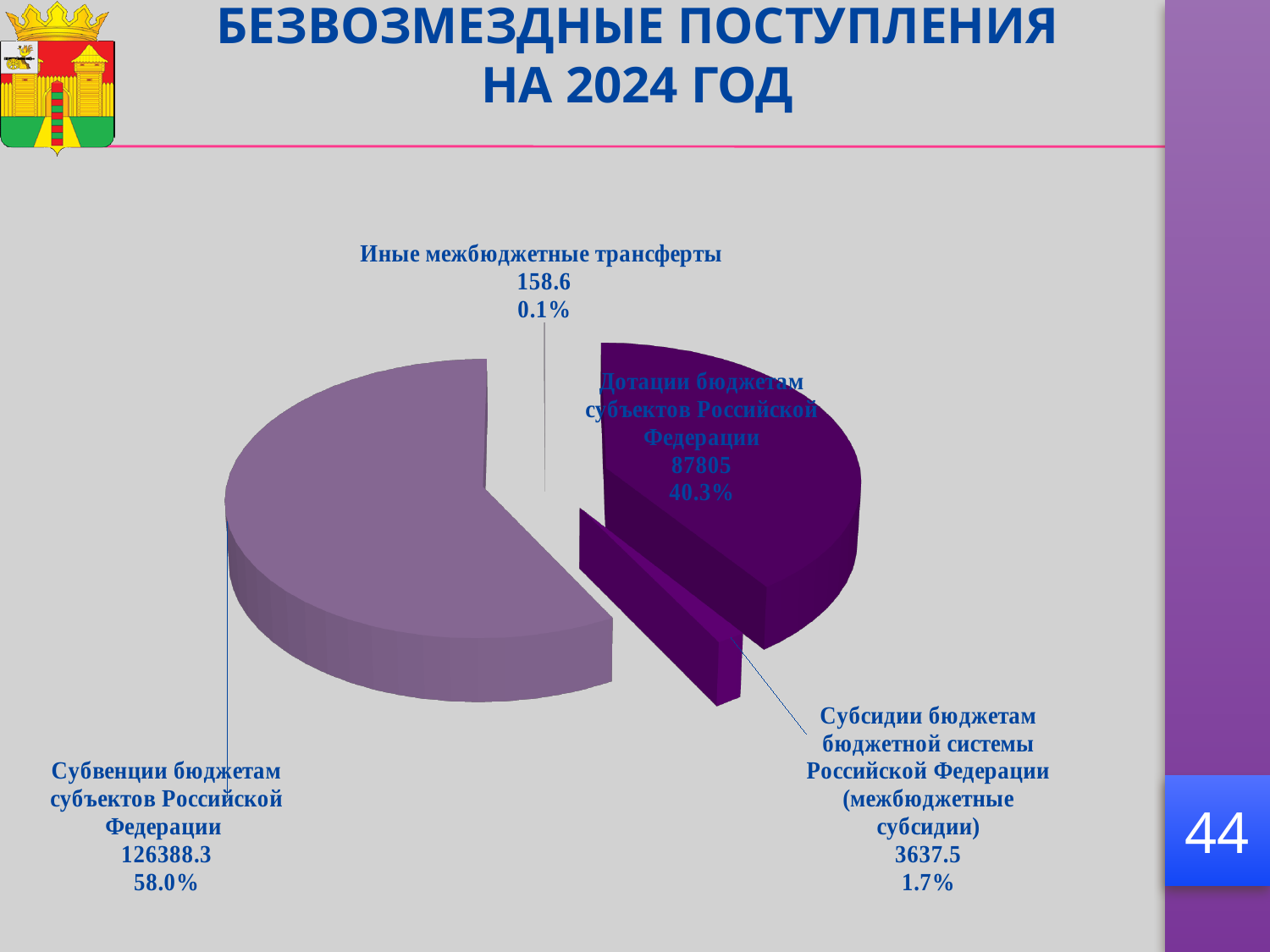
Какую долю круговой диаграммы занимают «Субсидии бюджетам бюджетной системы Российской Федерации (межбюджетные субсидии)»? 1.7% Какой тип диаграммы показан на слайде? круговая диаграмма Какое значение указано для категории «Дотации бюджетам субъектов Российской Федерации»? 87805 Какая категория имеет наибольшее значение на диаграмме? Субвенции бюджетам субъектов Российской Федерации На сколько значение «Субвенции бюджетам субъектов Российской Федерации» больше значения «Дотации бюджетам субъектов Российской Федерации»? 38583.3 Какое значение указано для категории «Субсидии бюджетам бюджетной системы Российской Федерации (межбюджетные субсидии)»? 3637.5 Какое значение указано для категории «Субвенции бюджетам субъектов Российской Федерации»? 126388.3 Сколько категорий (секторов) показано на круговой диаграмме? 4 Какое значение указано для категории «Иные межбюджетные трансферты»? 158.6 Какая категория имеет наименьшее значение на диаграмме? Иные межбюджетные трансферты Какую долю круговой диаграммы занимают «Дотации бюджетам субъектов Российской Федерации»? 40.3% Что больше: значение «Субсидии бюджетам бюджетной системы Российской Федерации (межбюджетные субсидии)» или «Иные межбюджетные трансферты»? Субсидии бюджетам бюджетной системы Российской Федерации (межбюджетные субсидии)